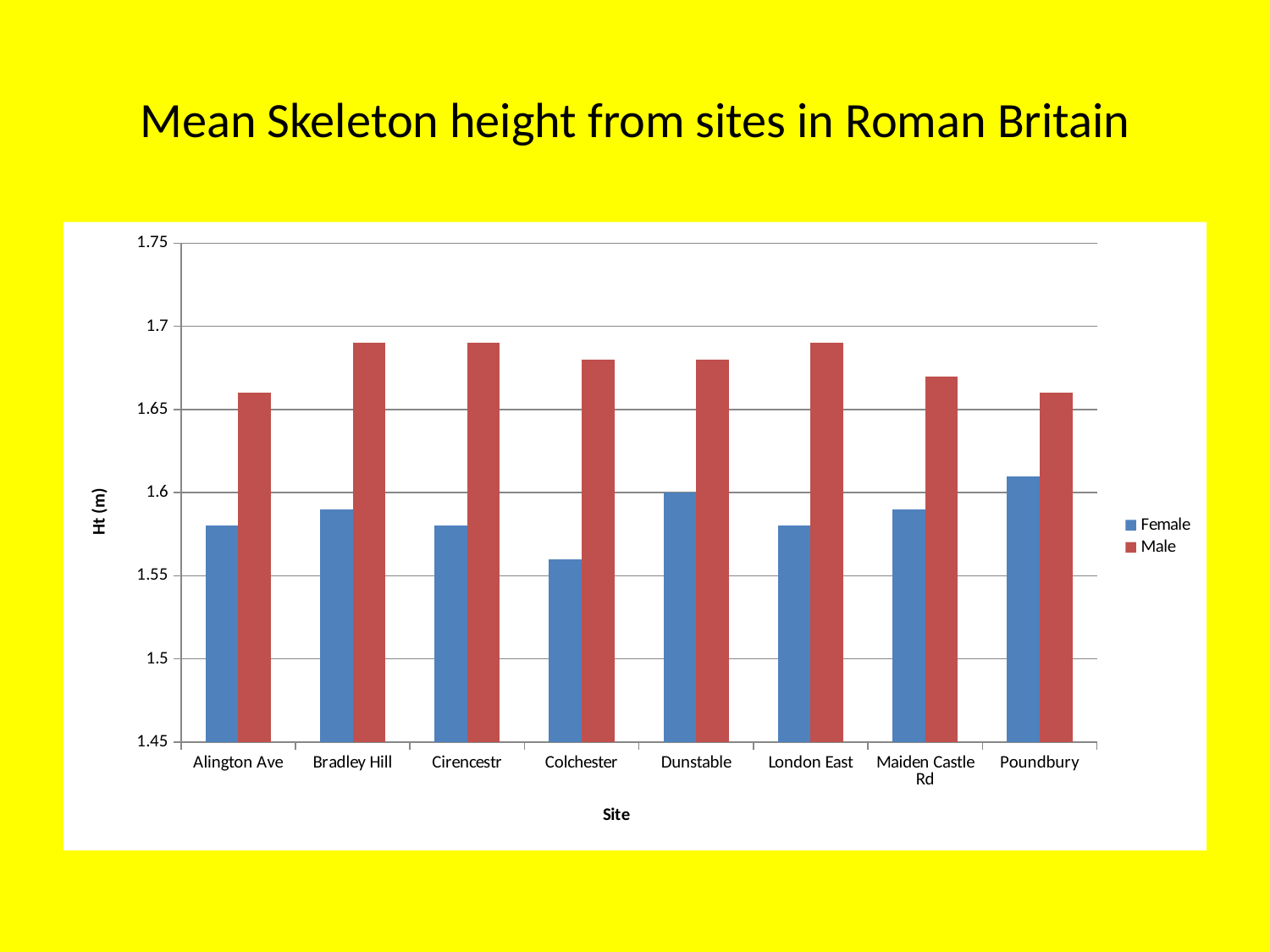
Which site has the lowest Female value? Colchester Is the Male value for Bradley Hill greater or less than 1.65? greater Is the Male value for Maiden Castle Rd greater or less than 1.7? less What kind of chart is shown on the slide? bar chart Which is larger, the Female value for Dunstable or the Female value for Colchester? Dunstable At Colchester, which is larger, the Male value or the Female value? Male How many series does the chart's legend list? 2 What is the Female value for Dunstable? 1.6 How many sites are shown on the x axis of the chart? 8 Is the Female value for Colchester greater or less than 1.6? less What is the label on the chart's vertical axis? Ht (m) Which site has the highest Female value? Poundbury